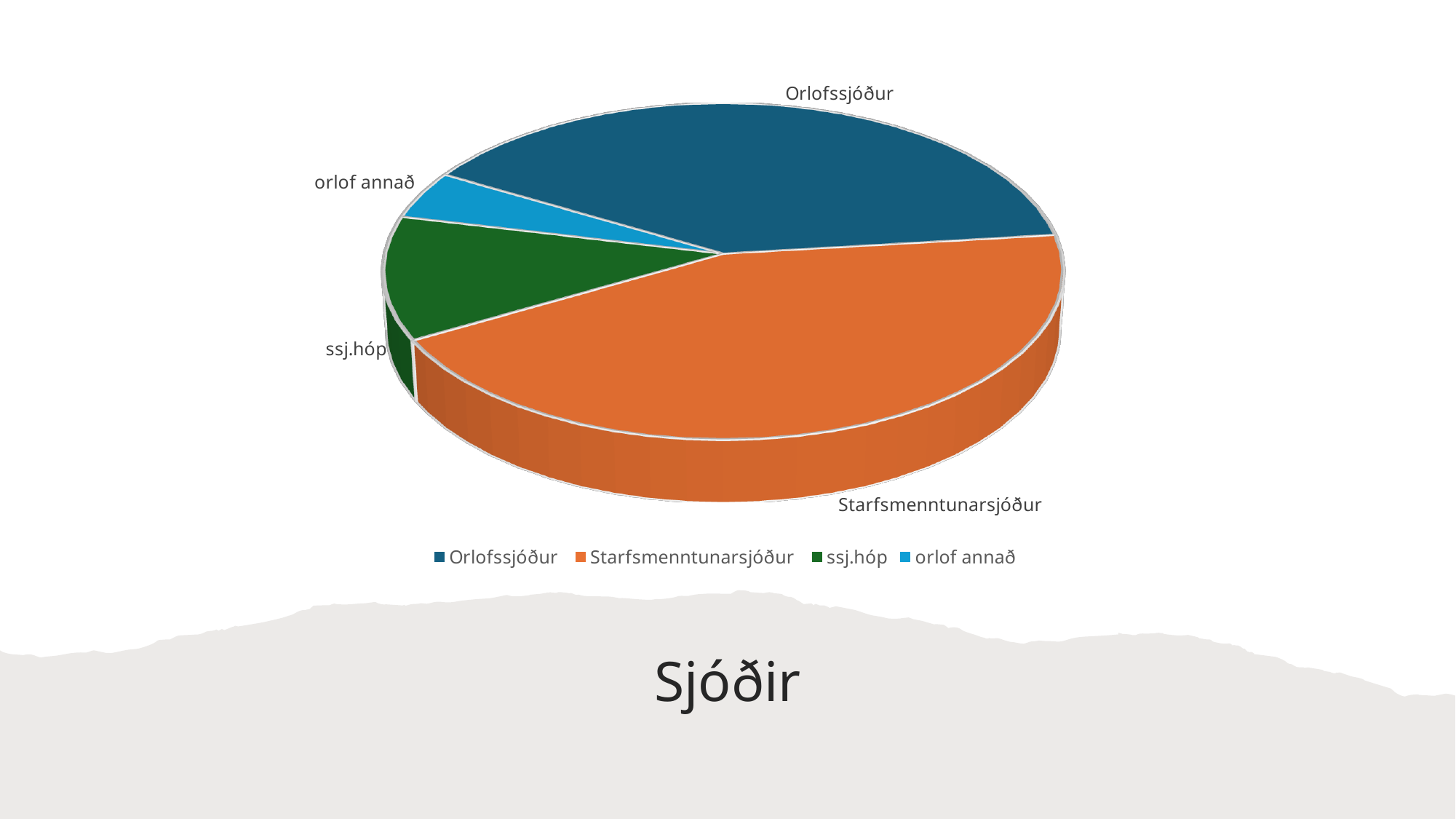
Which category has the largest slice of the pie chart? Starfsmenntunarsjóður How many entries does the legend of the pie chart list? 4 What kind of chart is shown on the slide? pie chart What is the title shown below the pie chart? Sjóðir How many slices does the pie chart have? 4 What colour is the Starfsmenntunarsjóður slice in the pie chart? orange Which slice is larger, Starfsmenntunarsjóður or Orlofssjóður? Starfsmenntunarsjóður Which slice is larger, Orlofssjóður or ssj.hóp? Orlofssjóður Which slice is larger, ssj.hóp or orlof annað? ssj.hóp Which category has the smallest slice of the pie chart? orlof annað